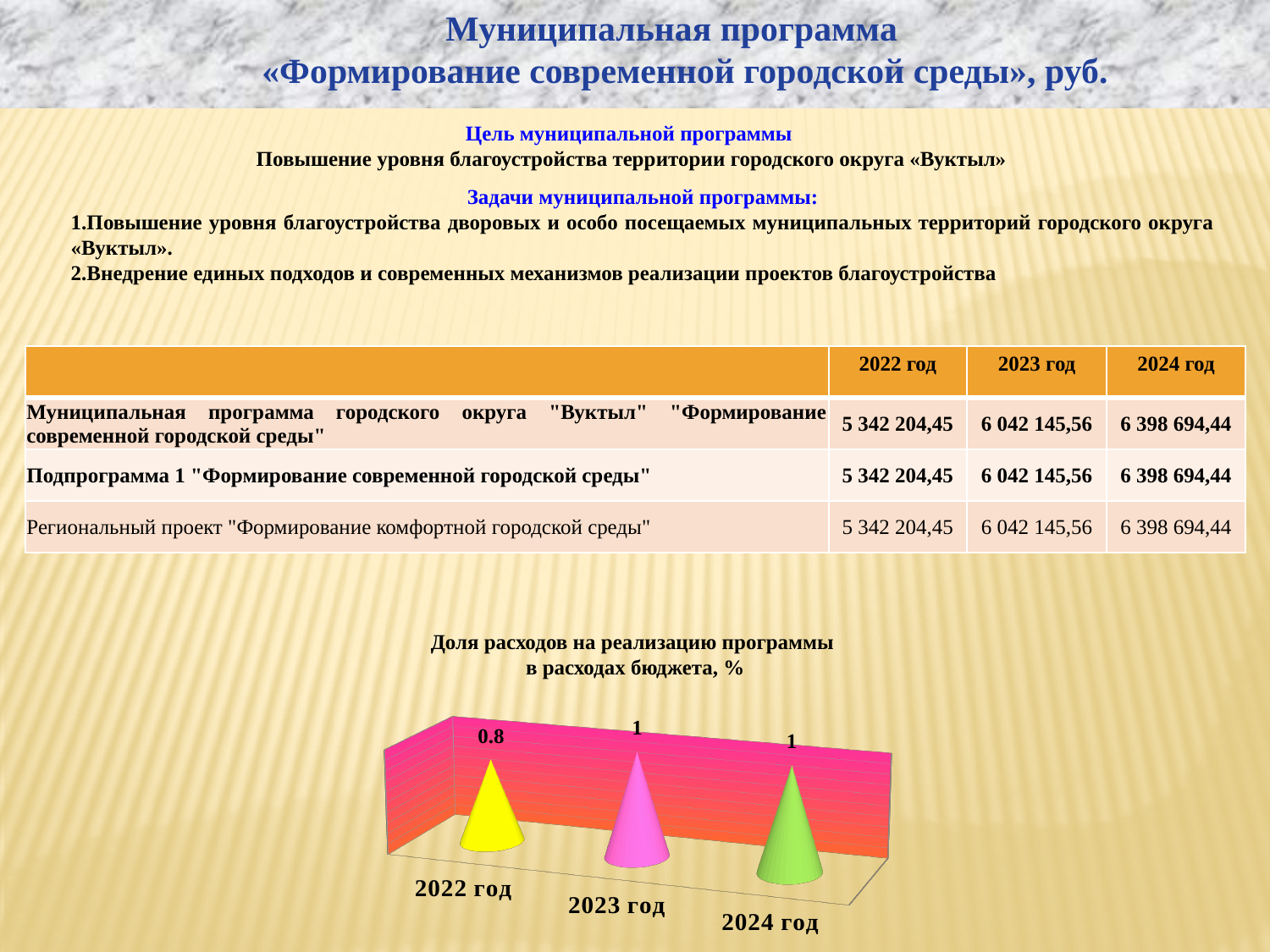
What is the value for 2022 год in the chart 'Доля расходов на реализацию программы в расходах бюджета, %'? 0.8 Is the value for 2022 год greater or less than 1? less Does the value rise or fall from 2022 год to 2023 год? rise What is the difference between the values for 2023 год and 2022 год? 0.2 How many years (categories) are shown in the chart? 3 What is the value for 2024 год in the chart? 1 Which year has the lowest value in the chart? 2022 год What colour is the cone for 2022 год? yellow What is the title of the chart? Доля расходов на реализацию программы в расходах бюджета, % Which is larger, the value for 2022 год or the value for 2023 год? 2023 год What is the value for 2023 год in the chart? 1 What kind of chart is shown at the bottom of the slide? bar chart